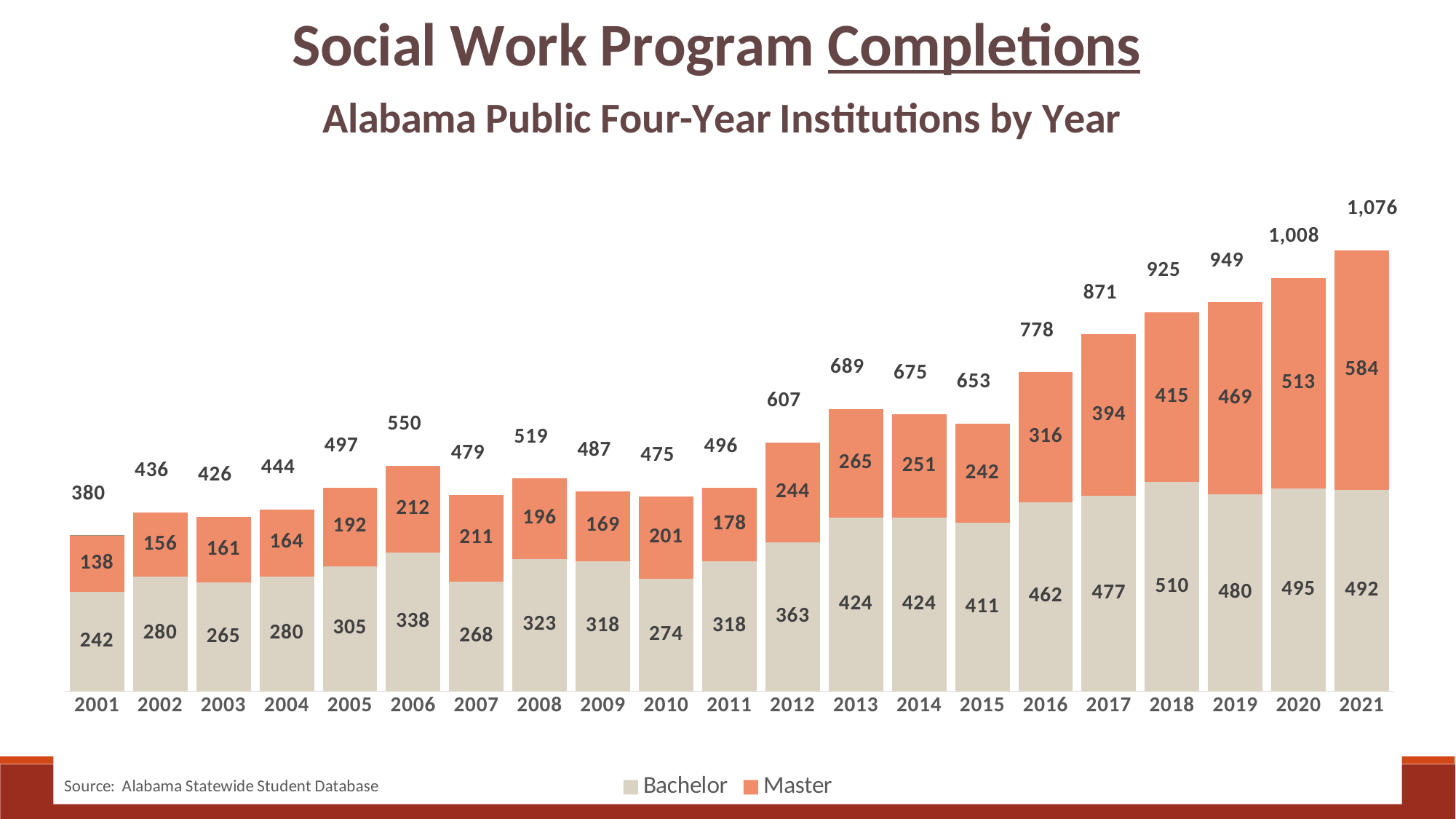
Which is larger, the Bachelor value for 2018 or the Bachelor value for 2019? 2018 How many series does the legend list? 2 How many years are shown on the x axis? 21 What is the Bachelor value for 2012? 363 What kind of chart is shown on the slide? Stacked bar chart Do total completions generally rise or fall from 2001 to 2021? Rise What is the difference between the Master values for 2021 and 2020? 71 What is the Master value for 2019? 469 What is the total of the stacked bar for 2021? 1,076 Which year has the highest total completions? 2021 Which year has the lowest total completions? 2001 What is the source cited at the bottom of the slide? Alabama Statewide Student Database